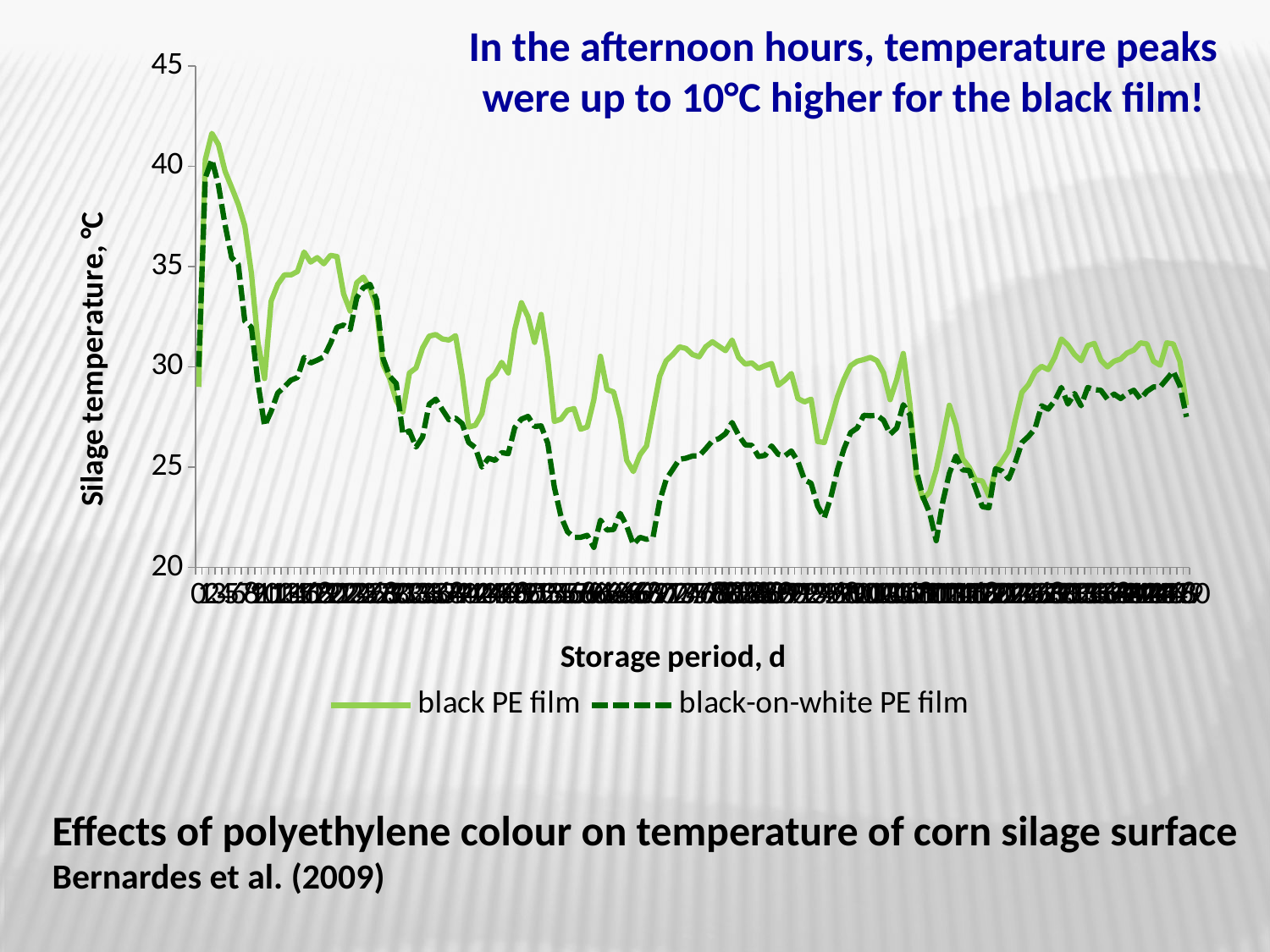
Is the lowest value of the black PE film series greater or less than 25? less Which series is drawn with a dashed line? black-on-white PE film What kind of chart is shown on the slide? line chart After its early peak, does the black PE film line generally rise or fall over the storage period? fall Which series reaches the higher peak temperature, black PE film or black-on-white PE film? black PE film Is the peak value of the black-on-white PE film series greater or less than 35? greater How many series does the legend list? 2 Which series has the lower minimum temperature, black PE film or black-on-white PE film? black-on-white PE film What is the title of the vertical axis? Silage temperature, °C Is the peak value of the black PE film series greater or less than 40? greater Which series lies above the other for most of the storage period? black PE film